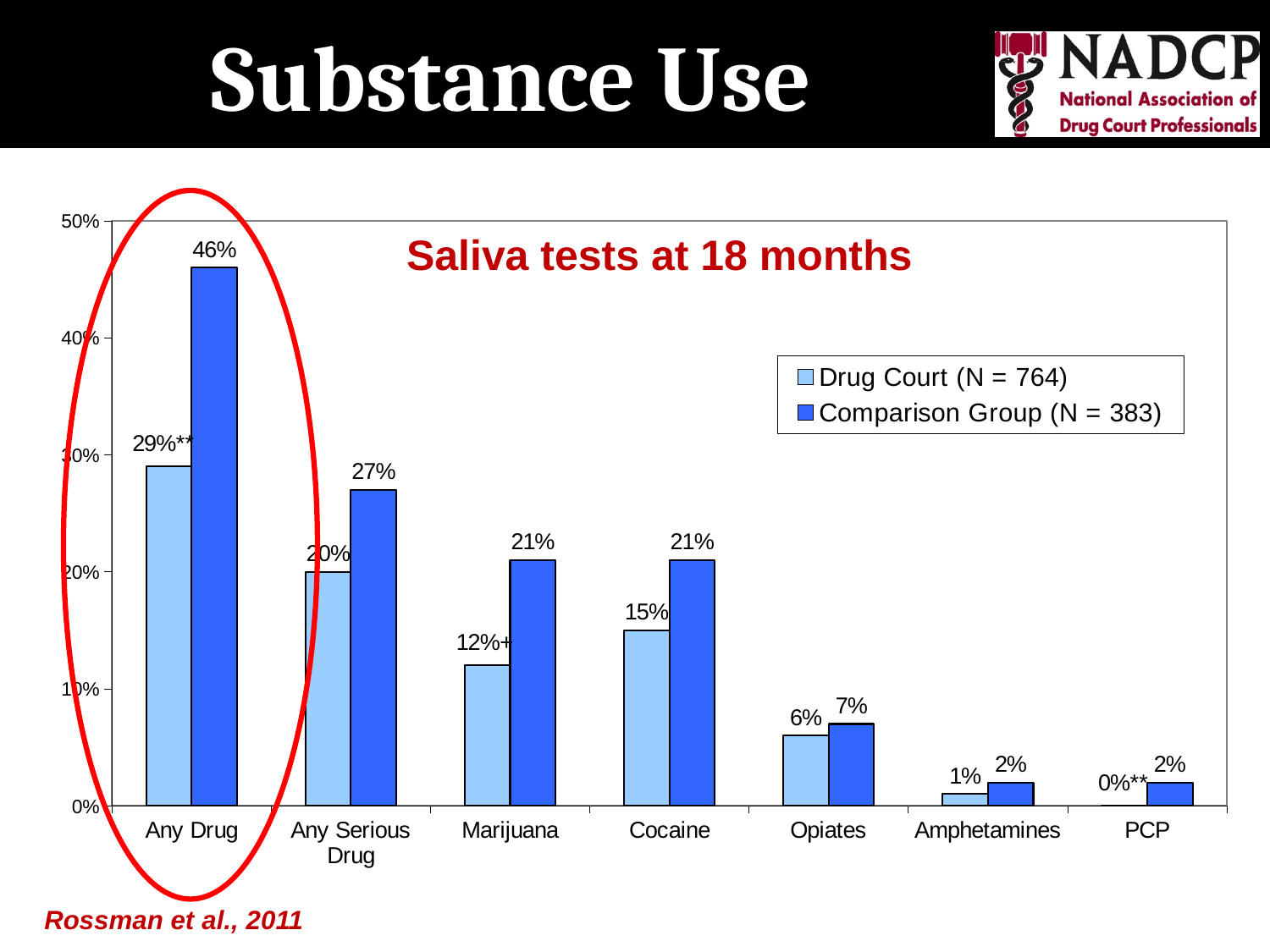
What is the Drug Court value for Cocaine? 15% Which is larger for Marijuana: the Drug Court value or the Comparison Group value? Comparison Group What is the Comparison Group value for Any Serious Drug? 27% What type of chart is shown on the slide? bar chart What is the sample size (N) of the Drug Court group shown in the legend? 764 Which category has the highest Comparison Group value? Any Drug How many substance categories are shown on the x axis? 7 What is the Drug Court value for Opiates? 6% What is the Comparison Group value for Any Drug? 46% What is the difference between the Comparison Group and Drug Court values for Any Drug? 17 percentage points Which category has the lowest Drug Court value? PCP How many series does the legend list? 2